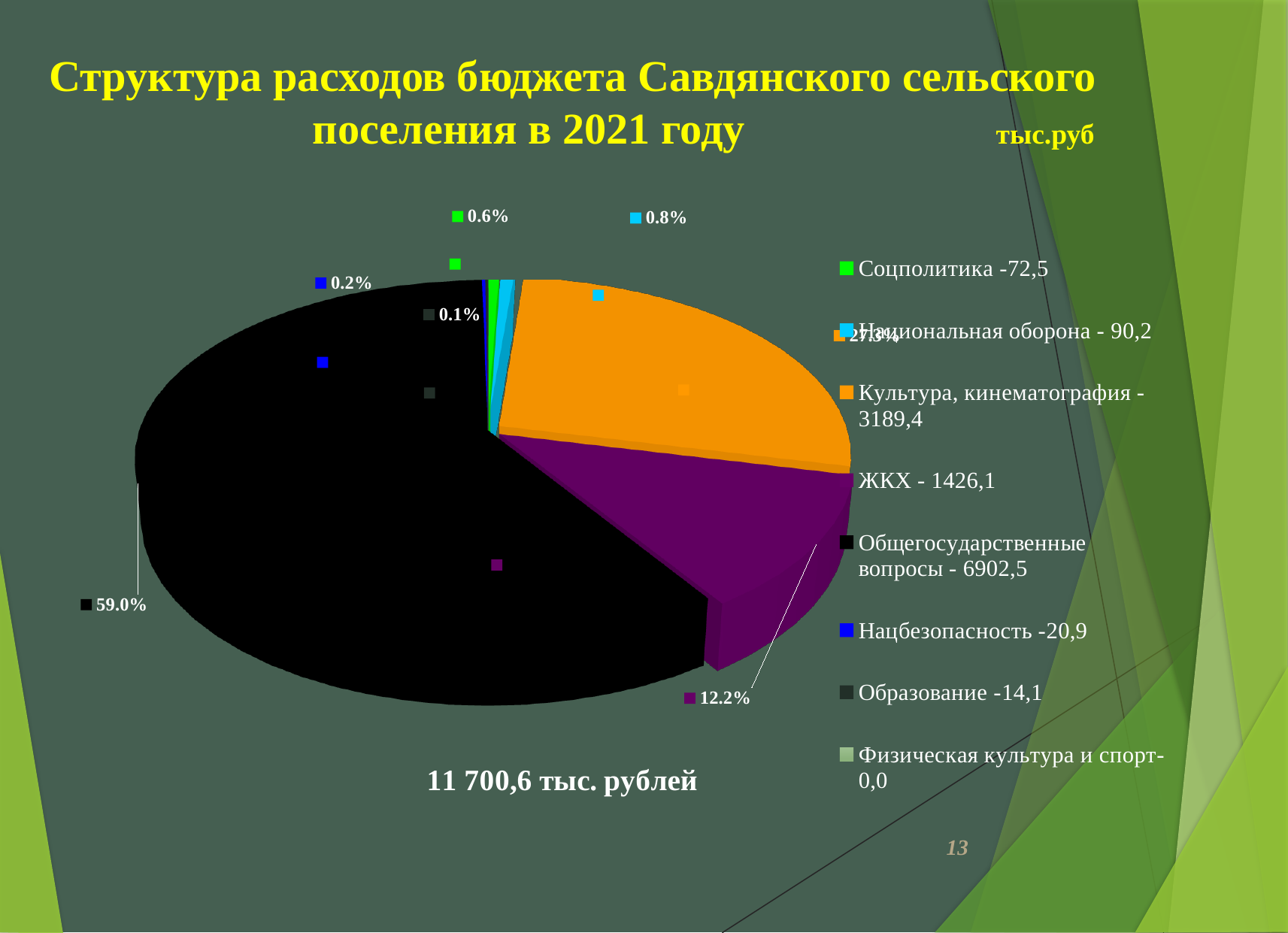
Which category has the largest share of the pie? Общегосударственные вопросы Which category has the smallest value in the legend? Физическая культура и спорт How many categories does the legend list? 8 What is the value shown in the legend for Национальная оборона? 90,2 What is the value shown in the legend for Культура, кинематография? 3189,4 What is the value shown in the legend for Общегосударственные вопросы? 6902,5 What percentage share of the pie is labelled for ЖКХ? 12.2% What percentage share of the pie is labelled for Общегосударственные вопросы? 59.0% What kind of chart is shown on the slide? Pie chart What is the value shown in the legend for ЖКХ? 1426,1 Which is larger, the value for ЖКХ or the value for Культура, кинематография? Культура, кинематография What is the difference between the values for Общегосударственные вопросы and Культура, кинематография? 3713,1